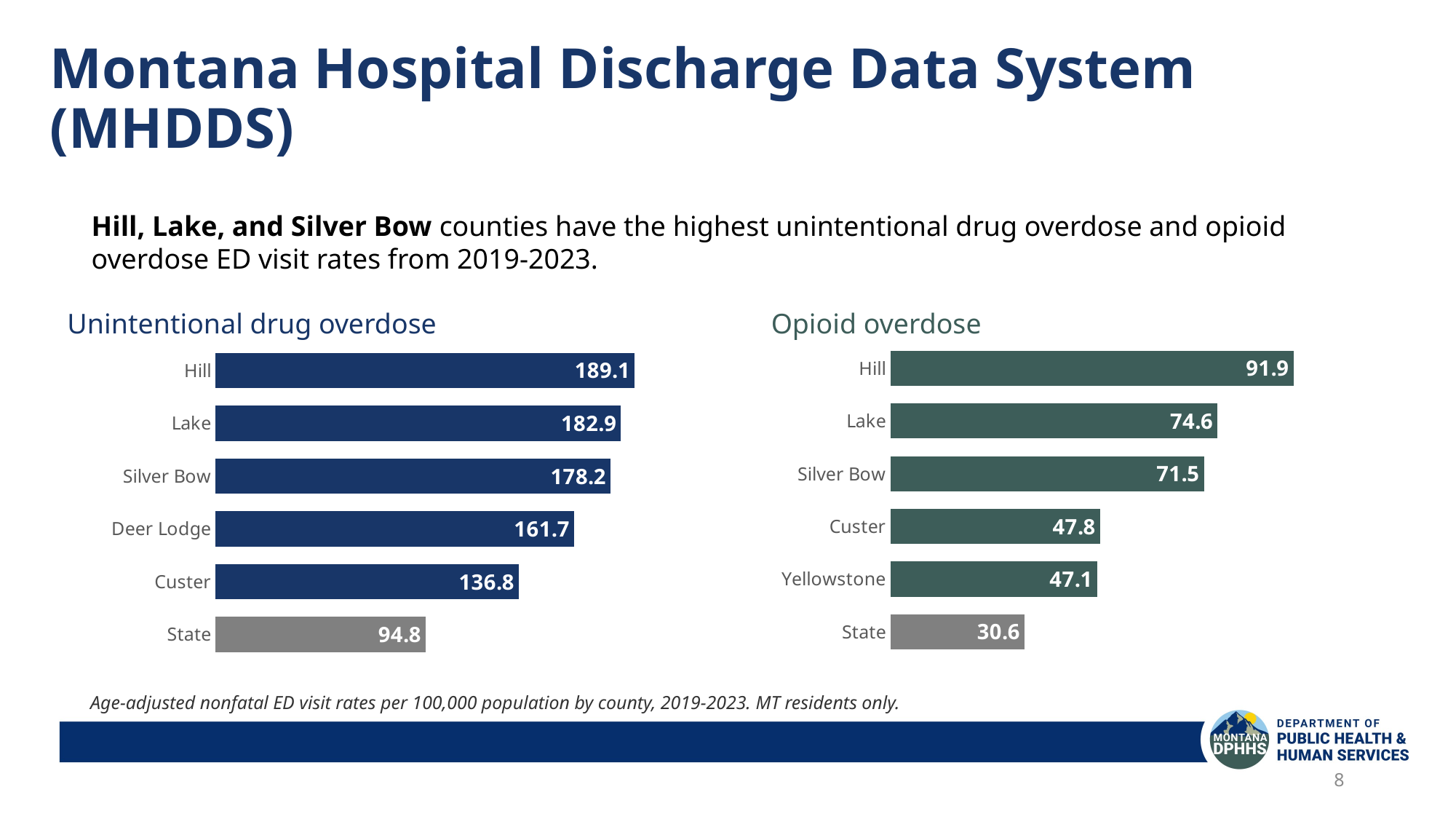
What kind of chart is the Opioid overdose chart? Bar chart In the Unintentional drug overdose chart, what is the value for Custer? 136.8 In the Opioid overdose chart, which category has the lowest value? State In the Opioid overdose chart, what is the value for Hill? 91.9 In the Opioid overdose chart, which is larger, the value for Custer or the value for Yellowstone? Custer In the Opioid overdose chart, what is the difference between the values for Lake and Silver Bow? 3.1 In the Unintentional drug overdose chart, what is the value for Deer Lodge? 161.7 In the Unintentional drug overdose chart, which bar is coloured grey rather than dark blue? State In the Opioid overdose chart, what is the value for Yellowstone? 47.1 In the Unintentional drug overdose chart, what is the difference between the values for Hill and State? 94.3 In the Unintentional drug overdose chart, which category has the highest value? Hill How many categories are shown in the Unintentional drug overdose chart? 6